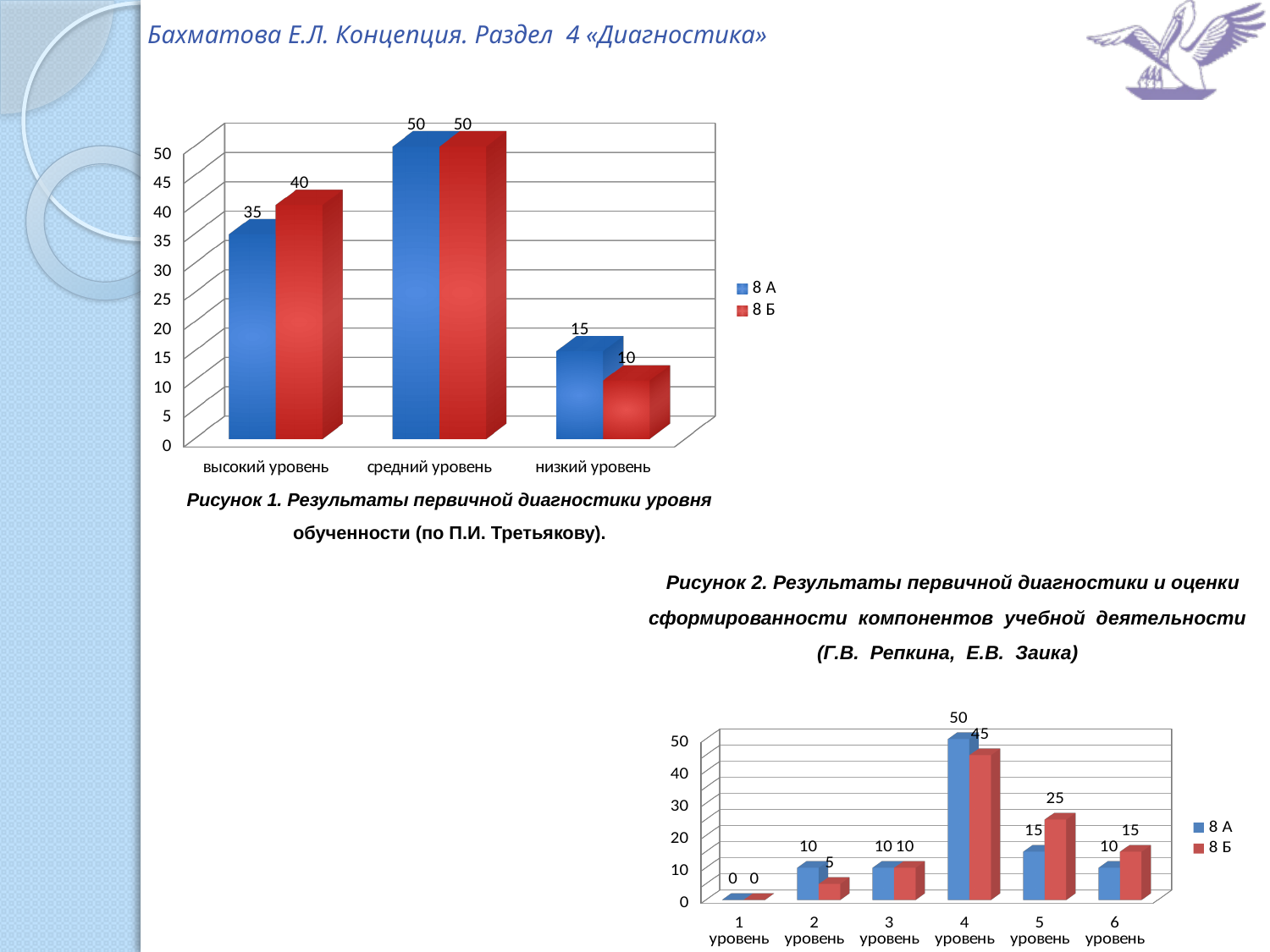
In the top chart (Рисунок 1), what is the value for 8 А at высокий уровень? 35 In the top chart (Рисунок 1), how many series does the legend list? 2 In the top chart (Рисунок 1), which is larger at низкий уровень: 8 А or 8 Б? 8 А In the top chart (Рисунок 1), what is the value for 8 Б at низкий уровень? 10 In the top chart (Рисунок 1), which category has the highest value for 8 А? средний уровень In the bottom chart (Рисунок 2), what is the value for 8 Б at 4 уровень? 45 In the bottom chart (Рисунок 2), which level has the lowest value for 8 Б? 1 уровень In the top chart (Рисунок 1), what is the difference between 8 Б and 8 А at высокий уровень? 5 In the bottom chart (Рисунок 2), what is the value for 8 А at 5 уровень? 15 In the bottom chart (Рисунок 2), what is the difference between 8 Б and 8 А at 5 уровень? 10 In the bottom chart (Рисунок 2), how many categories are shown on the x axis? 6 What kind of chart is the bottom chart (Рисунок 2)? bar chart